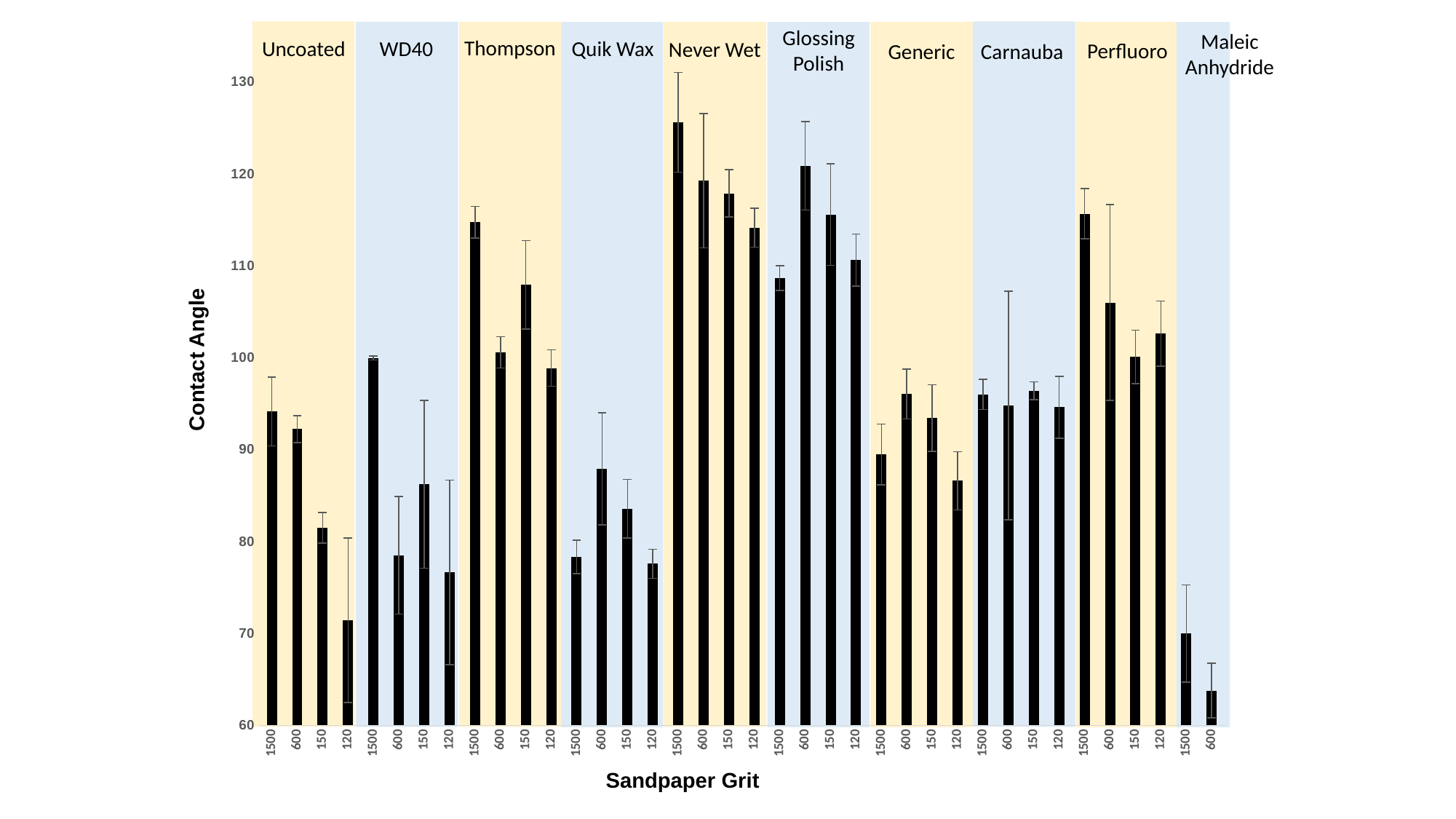
Which is larger, the contact angle for Thompson at 1500 grit or for WD40 at 1500 grit? Thompson at 1500 grit How many bars are plotted in the Maleic Anhydride group? 2 What is the label of the vertical axis? Contact Angle What kind of chart is shown on the slide? bar chart Within the Uncoated group, do the contact angles rise or fall going from 1500 grit to 120 grit? fall Is the contact angle for Never Wet at 1500 grit greater or less than 120? greater Is the contact angle for Perfluoro at 1500 grit greater or less than 110? greater Is the contact angle for Uncoated at 120 grit greater or less than 80? less Which coating and grit has the highest contact angle on the chart? Never Wet, 1500 Which coating and grit has the lowest contact angle on the chart? Maleic Anhydride, 600 How many coating groups are labelled along the top of the chart? 10